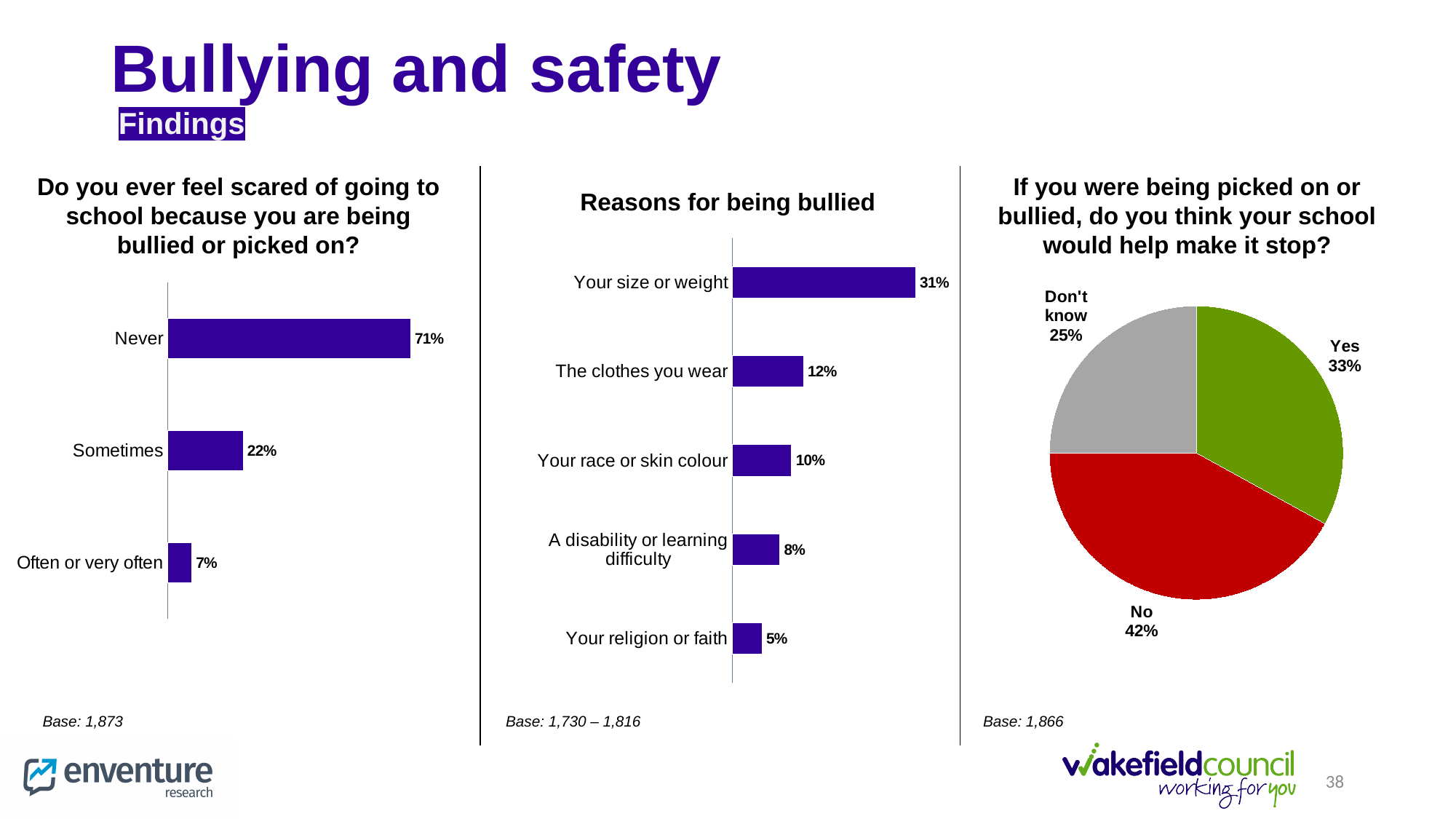
In the left chart 'Do you ever feel scared of going to school because you are being bullied or picked on?', what is the value for 'Never'? 71% In the middle chart 'Reasons for being bullied', how many reasons are listed? 5 In the left chart 'Do you ever feel scared of going to school because you are being bullied or picked on?', how many categories are shown? 3 In the right chart 'If you were being picked on or bullied, do you think your school would help make it stop?', what colour is the 'Yes' slice? Green What kind of chart is the middle chart 'Reasons for being bullied'? Bar chart In the middle chart 'Reasons for being bullied', what is the value for 'The clothes you wear'? 12% In the right chart 'If you were being picked on or bullied, do you think your school would help make it stop?', what is the difference between 'Yes' and 'Don't know'? 8 percentage points In the left chart 'Do you ever feel scared of going to school because you are being bullied or picked on?', what is the difference between 'Never' and 'Sometimes'? 49 percentage points In the middle chart 'Reasons for being bullied', which is larger: 'Your race or skin colour' or 'A disability or learning difficulty'? Your race or skin colour In the right chart 'If you were being picked on or bullied, do you think your school would help make it stop?', what share of the pie is 'No'? 42% In the left chart 'Do you ever feel scared of going to school because you are being bullied or picked on?', which category has the lowest value? Often or very often In the middle chart 'Reasons for being bullied', which reason has the highest value? Your size or weight